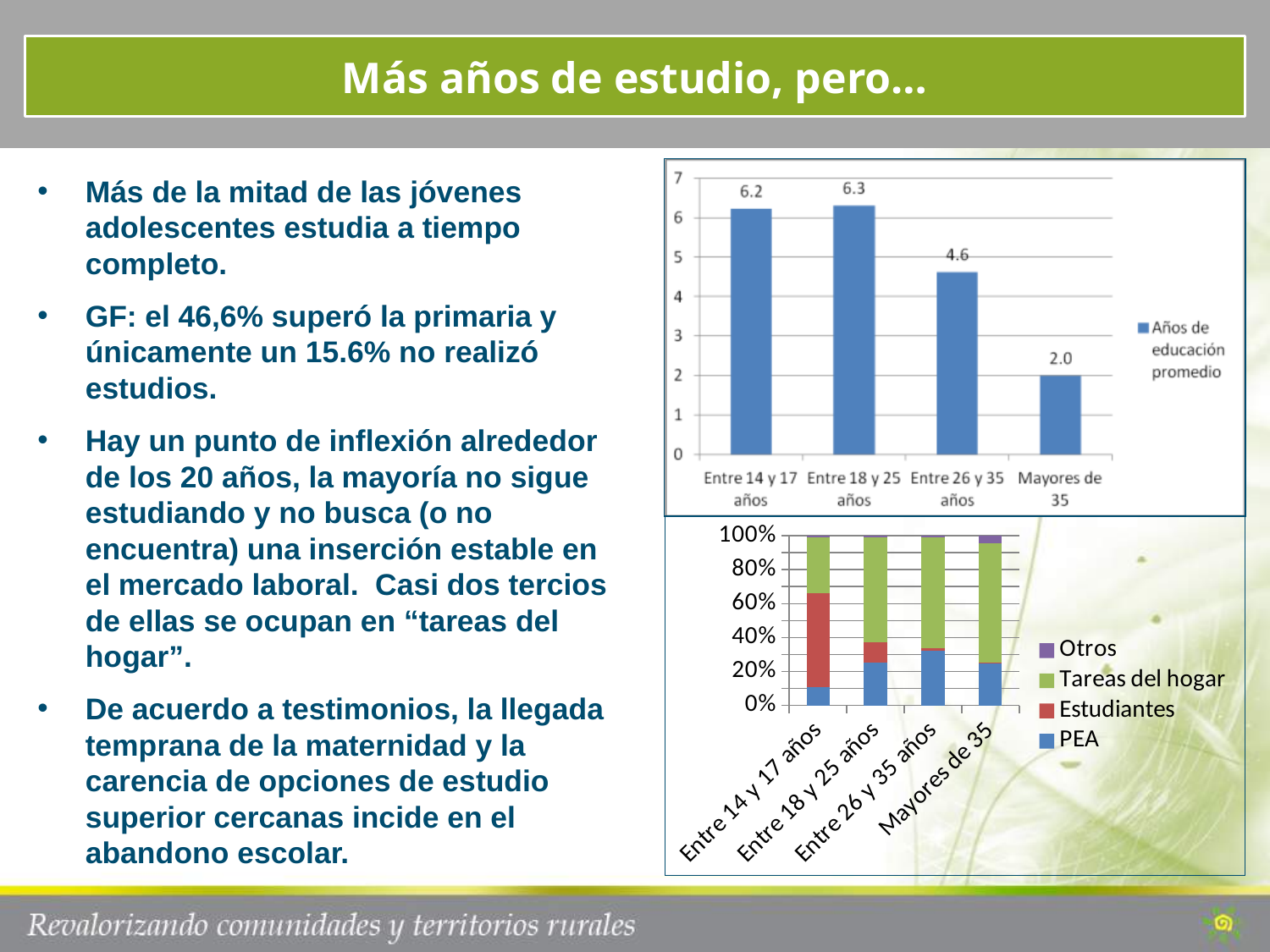
In the bottom stacked bar chart, is the 'Tareas del hogar' share for 'Mayores de 35' greater or less than 60%? greater In the top bar chart, which age group has the highest average years of education? Entre 18 y 25 años In the top bar chart, which age group has the lowest value? Mayores de 35 How many age groups are shown in the top bar chart? 4 In the top bar chart, what is the difference between the values for 'Entre 14 y 17 años' and 'Mayores de 35'? 4.2 In the top bar chart, from 'Entre 18 y 25 años' to 'Mayores de 35', do the values rise or fall? fall In the top bar chart, what is the value for 'Entre 26 y 35 años'? 4.6 In the top bar chart, which is larger: the value for 'Entre 14 y 17 años' or for 'Entre 26 y 35 años'? Entre 14 y 17 años What kind of chart is the top chart on the slide? Bar chart In the top bar chart, what is the value for 'Mayores de 35'? 2.0 In the top bar chart, what is the difference between the values for 'Entre 18 y 25 años' and 'Entre 26 y 35 años'? 1.7 How many series does the legend of the bottom stacked bar chart list? 4